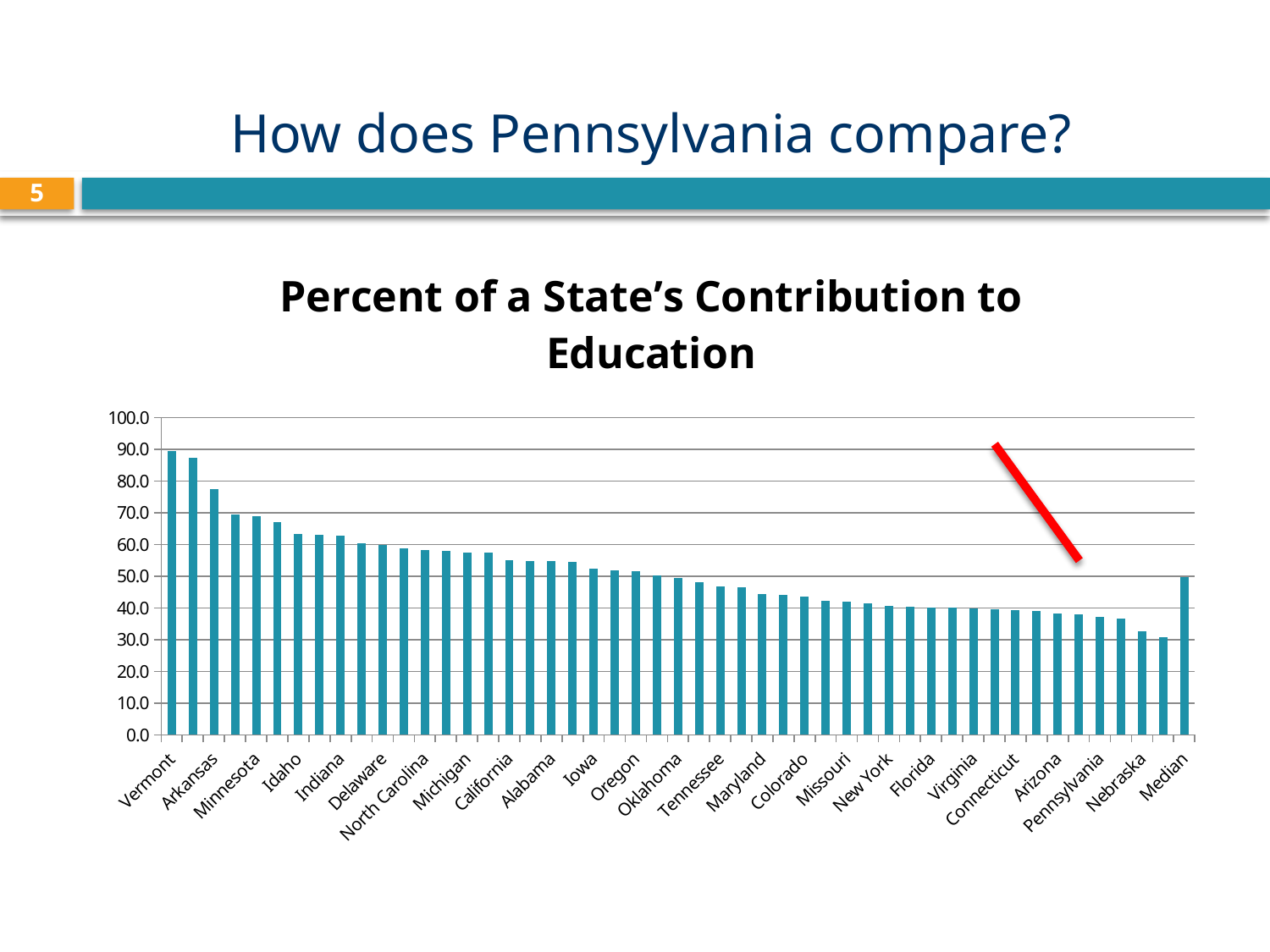
Do the bar values generally rise or fall moving from left to right along the x axis (excluding the final Median bar)? fall Is the value for Tennessee greater or less than 50? less Is the value for North Carolina greater or less than 60? less Is the value for Vermont greater or less than 80? greater Which state has the highest bar in the chart? Vermont Which is larger, the value for Vermont or the value for Pennsylvania? Vermont Which state's bar does the red line on the chart point to? Pennsylvania What is the title of the chart? Percent of a State's Contribution to Education What kind of chart is shown on the slide? Bar chart